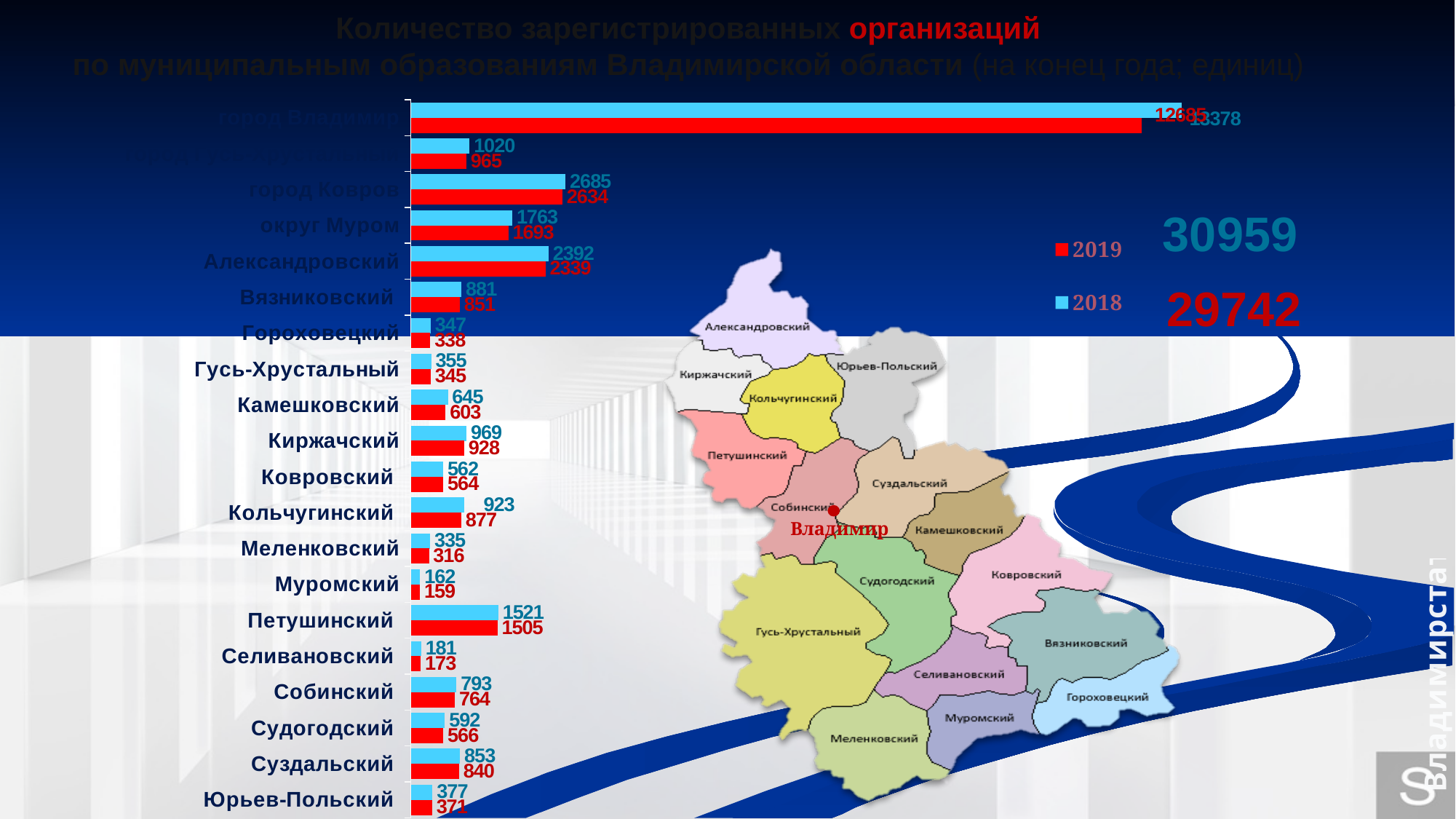
What is the difference between the 2018 and 2019 values for Александровский? 53 What is the value for Муромский in 2019? 159 What is the value for город Ковров in 2019? 2634 Which municipality has the lowest value in 2018? Муромский How many series does the legend list? 2 What type of chart is shown on the slide? bar chart For Ковровский, which year has the larger value, 2018 or 2019? 2019 How many municipalities are shown on the chart? 20 What is the difference between the 2018 and 2019 values for Собинский? 29 Which municipality has the highest value in 2019? город Владимир What is the value for Петушинский in 2018? 1521 What is the value for Кольчугинский in 2019? 877